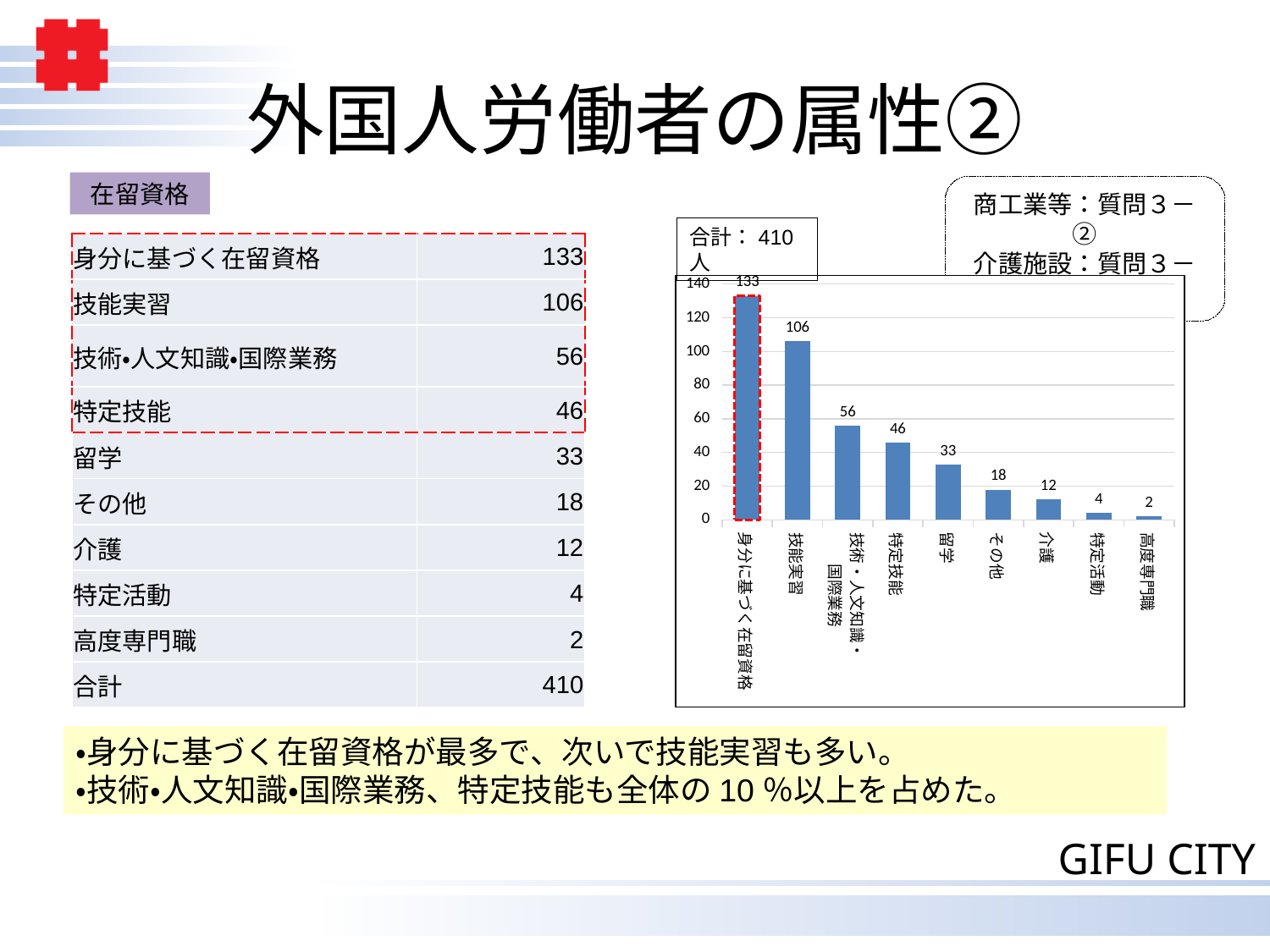
What is the value for 技能実習 in the bar chart? 106 How many categories are plotted in the bar chart? 9 What is the difference between the values for 身分に基づく在留資格 and 技能実習? 27 Which is larger, the value for 留学 or the value for その他? 留学 Do the values rise or fall from left to right along the x axis? fall What is the difference between the values for 技術・人文知識・国際業務 and 特定技能? 10 What is the value for 介護 in the bar chart? 12 What is the value for 特定技能 in the bar chart? 46 Which category has the lowest value in the bar chart? 高度専門職 Which category has the highest value in the bar chart? 身分に基づく在留資格 What kind of chart is shown on the slide? bar chart What total number of people is stated in the box above the chart? 410人